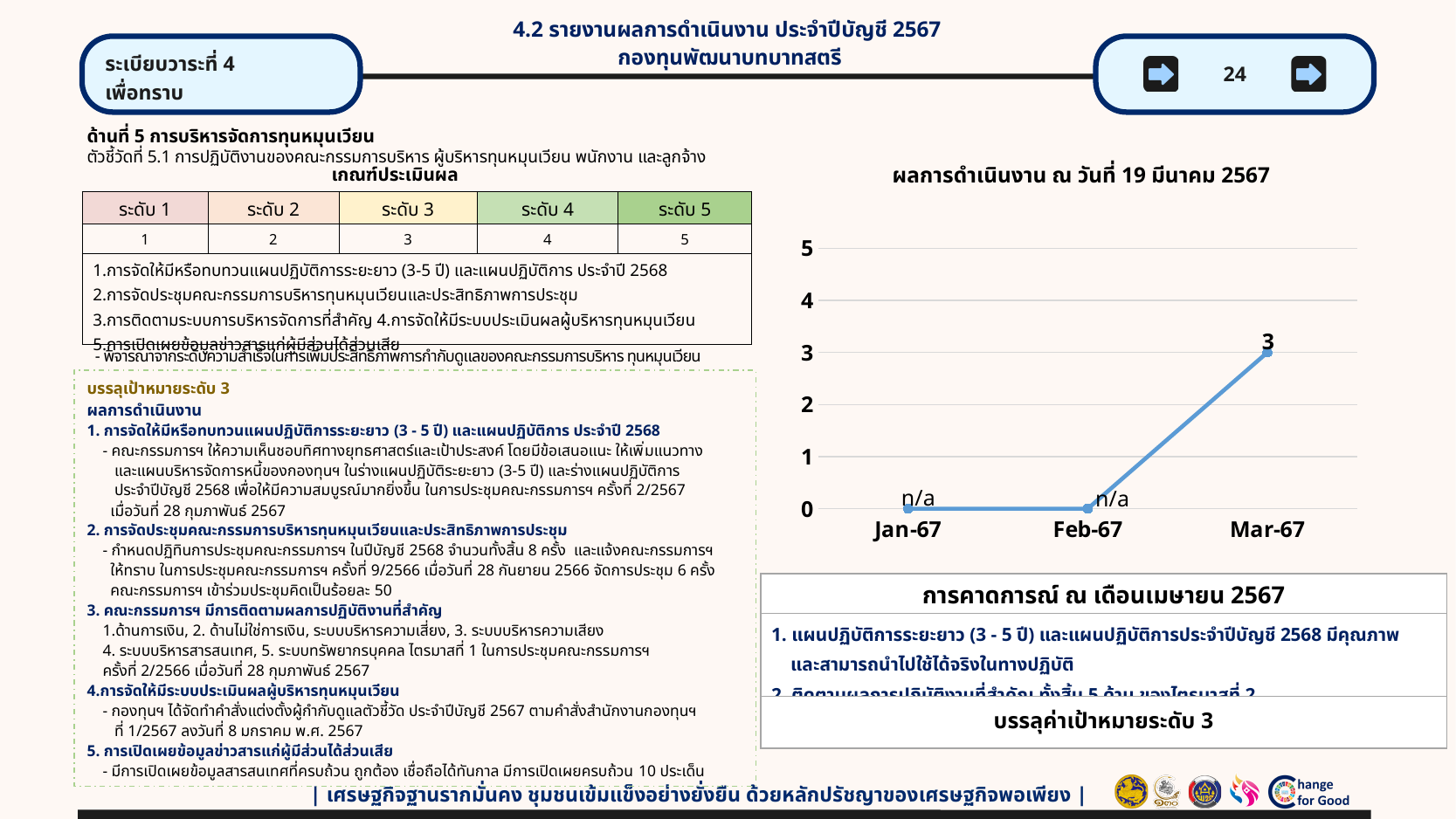
What is the highest value shown on the y axis of the chart? 5 What is the value for Mar-67 in the chart? 3 Is the value for Mar-67 greater or less than 2? greater What type of chart is shown on the slide? line chart How many points are plotted along the x axis of the chart? 3 Which month has the highest value in the chart? Mar-67 What data label is shown for Feb-67 in the chart? n/a Does the line rise or fall from Feb-67 to Mar-67? rise What is the title of the chart? ผลการดำเนินงาน ณ วันที่ 19 มีนาคม 2567 Which is larger, the plotted value for Feb-67 or for Mar-67? Mar-67 What data label is shown for Jan-67 in the chart? n/a Is the value for Mar-67 greater or less than 4? less